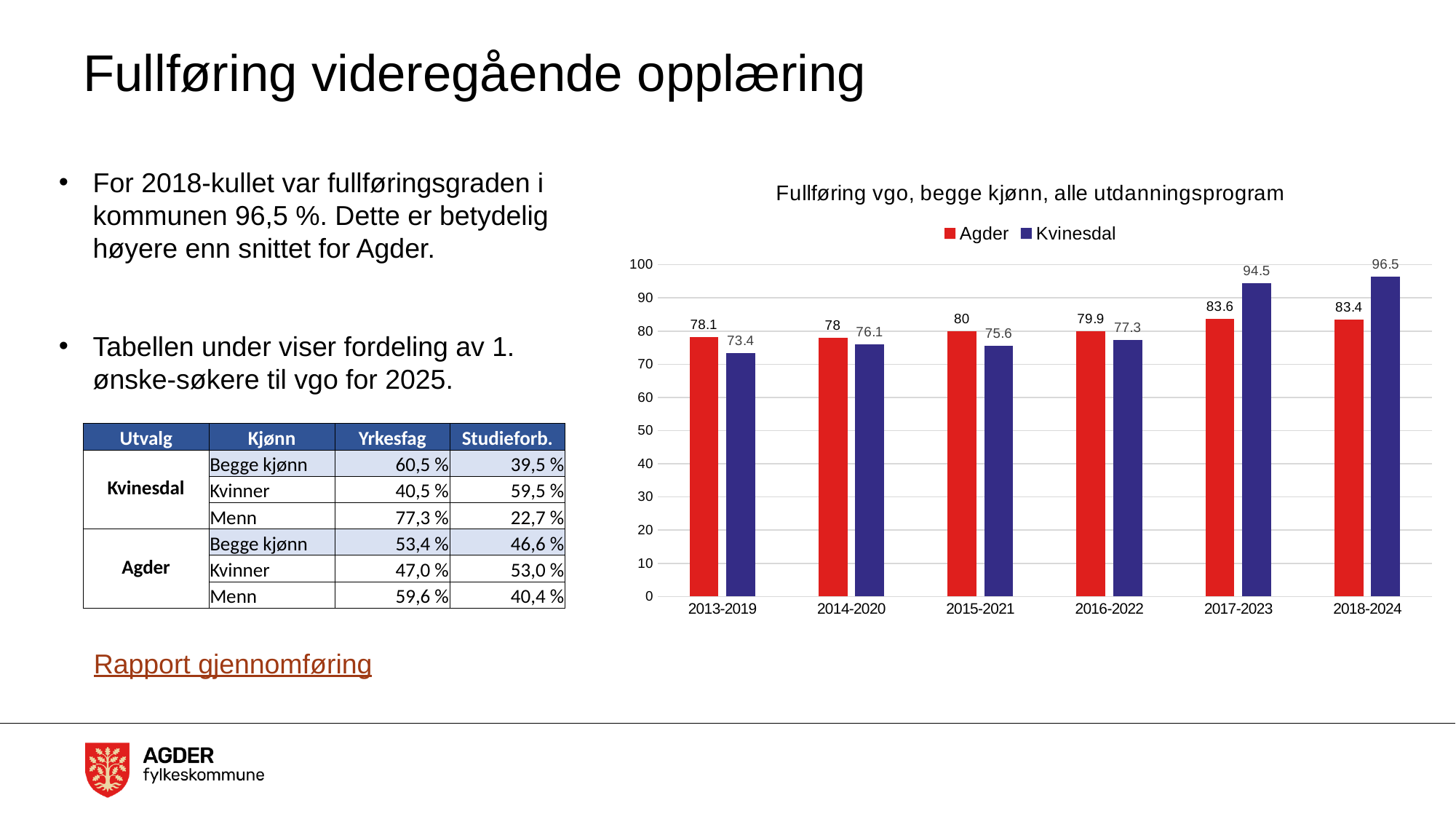
What is the difference between Kvinesdal and Agder in 2018-2024? 13.1 Is the value for Kvinesdal in 2017-2023 greater or less than 90? greater How many series does the legend list? 2 What kind of chart is shown? bar chart What is the value for Agder in 2015-2021? 80 Which period has the highest value for Kvinesdal? 2018-2024 How many periods are shown on the x axis? 6 Which period has the lowest value for Kvinesdal? 2013-2019 What is the value for Kvinesdal in 2018-2024? 96.5 Which is larger in 2013-2019, Agder or Kvinesdal? Agder What is the title of the chart? Fullføring vgo, begge kjønn, alle utdanningsprogram What is the value for Kvinesdal in 2013-2019? 73.4